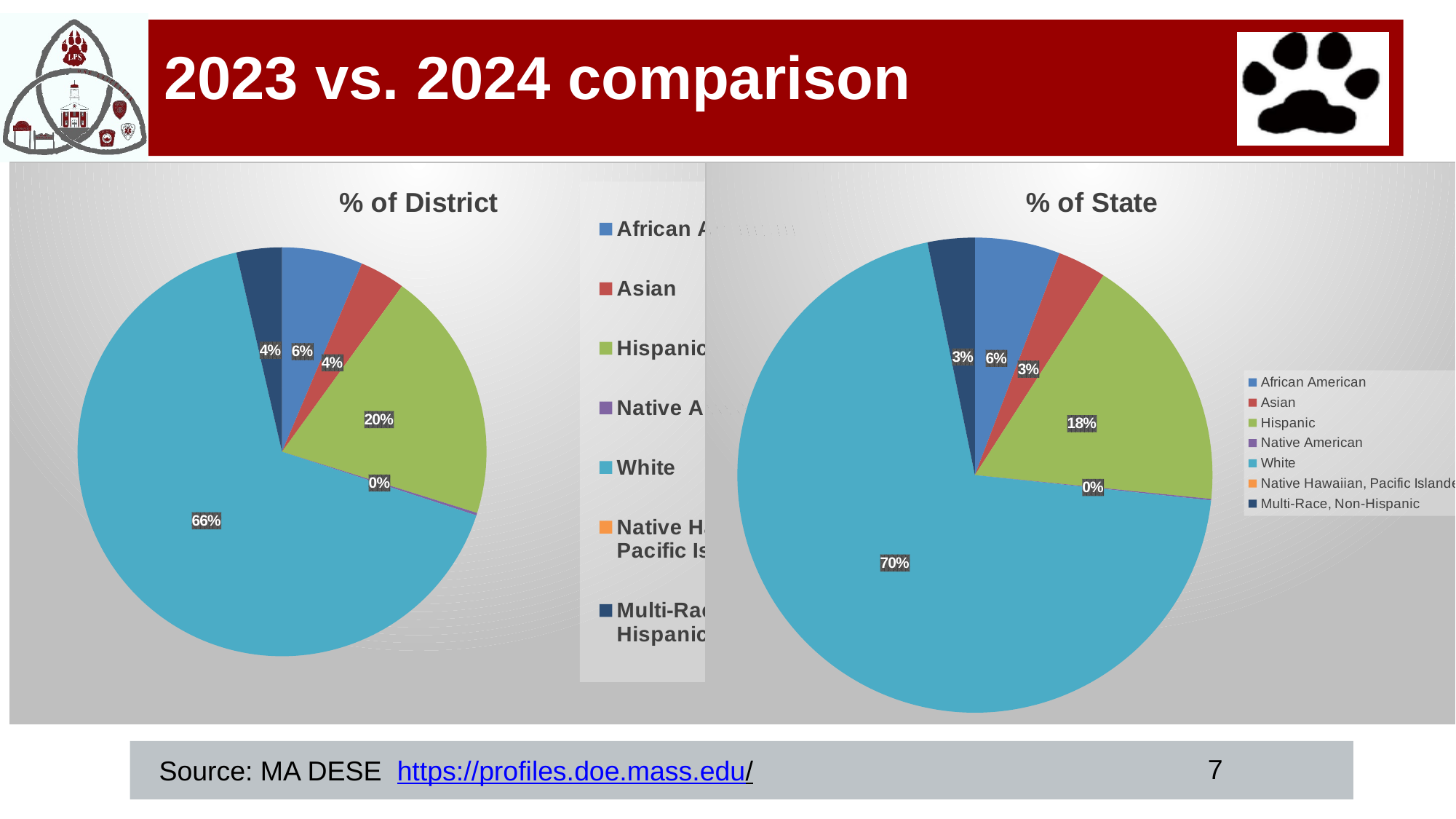
In the "% of District" pie chart, what percentage is shown for White? 66% In the "% of District" pie chart, what is the difference between the Hispanic and African American percentages? 14% Is the Hispanic share larger in the "% of District" chart or the "% of State" chart? % of District In the "% of State" pie chart, what percentage is shown for Asian? 3% What is the difference between the White share in the "% of State" chart and the White share in the "% of District" chart? 4% In the "% of State" pie chart, what percentage is shown for Hispanic? 18% In the "% of State" pie chart, which category has the largest slice? White How many categories does the legend of the "% of State" chart list? 7 In the "% of District" pie chart, what percentage is shown for African American? 6% What type of chart is used for "% of State"? Pie chart In the "% of District" pie chart, which category has the largest slice? White What colour represents Hispanic in the "% of State" pie chart? Green